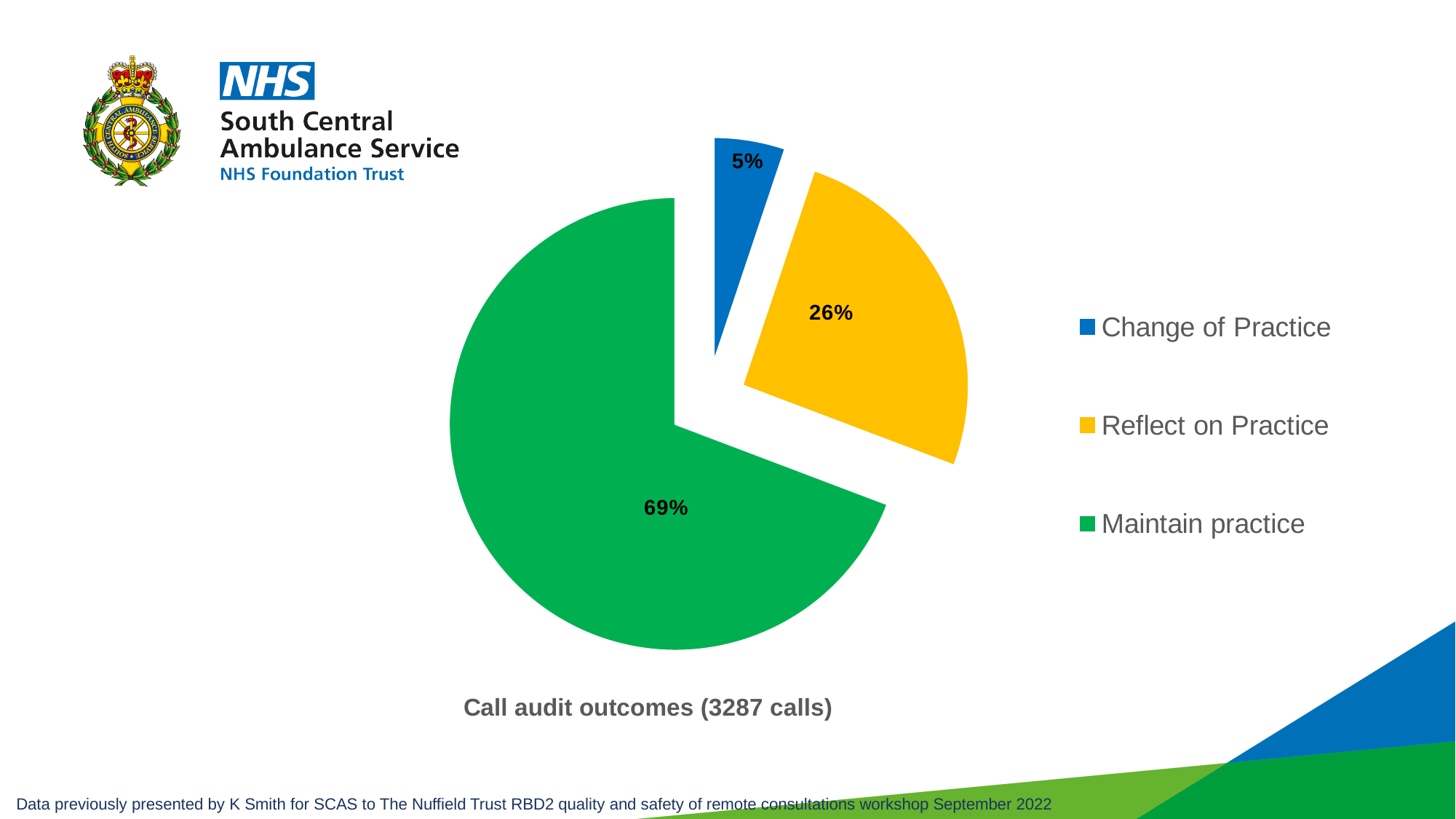
How many calls were included in the call audit, according to the chart title? 3287 What is the difference in percentage points between 'Maintain practice' and 'Reflect on Practice'? 43 Which outcome has the smallest share of the pie? Change of Practice Which is larger: the share for 'Reflect on Practice' or 'Change of Practice'? Reflect on Practice What colour is the 'Reflect on Practice' slice? Yellow What percentage of call audit outcomes were 'Change of Practice'? 5% What percentage of call audit outcomes were 'Maintain practice'? 69% How many categories does the pie chart show? 3 What is the combined share of 'Reflect on Practice' and 'Change of Practice'? 31% What percentage of call audit outcomes were 'Reflect on Practice'? 26% What type of chart is shown on the slide? Pie chart Which outcome has the largest share of the pie? Maintain practice